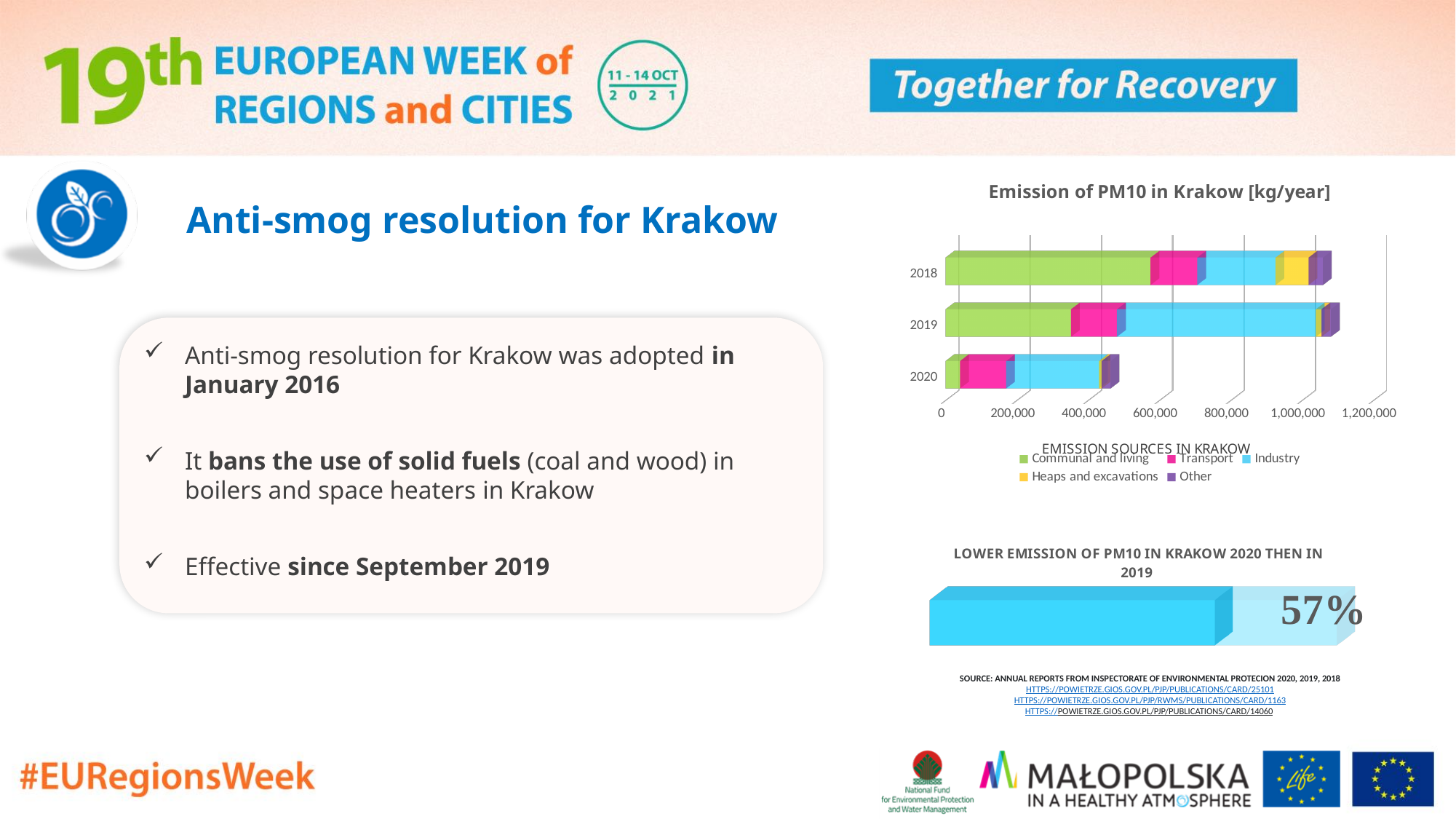
In the 'Emission of PM10 in Krakow [kg/year]' chart, which series is shown in green? Communal and living What is the unit given in the title of the chart at the top right of the slide? kg/year In the 'Emission of PM10 in Krakow [kg/year]' chart, which year has the larger Communal and living emission, 2018 or 2020? 2018 In the 'Emission of PM10 in Krakow [kg/year]' chart, which year has the lowest total emission? 2020 In the 'Emission of PM10 in Krakow [kg/year]' chart, is the total emission for 2018 greater or less than 1,000,000? greater How many emission sources does the legend of the 'Emission of PM10 in Krakow [kg/year]' chart list? 5 In the 'Emission of PM10 in Krakow [kg/year]' chart, is the total emission for 2020 greater or less than 600,000? less How many years are shown on the 'Emission of PM10 in Krakow [kg/year]' chart? 3 What value is shown on the 'LOWER EMISSION OF PM10 IN KRAKOW 2020 THEN IN 2019' chart? 57% In the 'Emission of PM10 in Krakow [kg/year]' chart, is the Communal and living value for 2018 greater or less than 400,000? greater What kind of chart is the 'Emission of PM10 in Krakow [kg/year]' chart? stacked bar chart